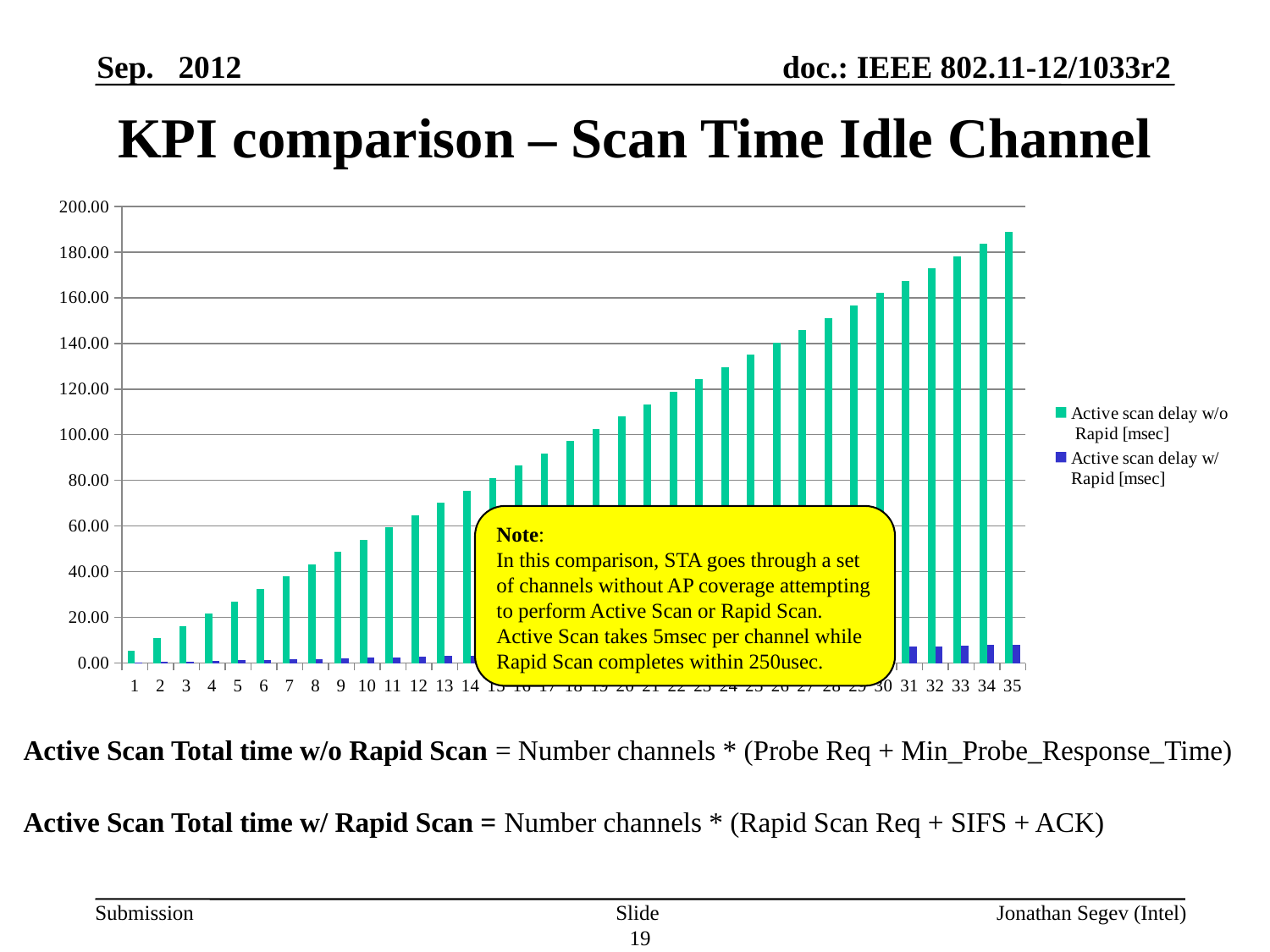
How many categories are shown along the x axis? 35 Is the value for 'Active scan delay w/o Rapid [msec]' at category 35 greater or less than 180? greater Is the value for 'Active scan delay w/o Rapid [msec]' at category 20 greater or less than 100? greater Which category has the highest value for the 'Active scan delay w/o Rapid [msec]' series? 35 What is the title of the slide containing the chart? KPI comparison – Scan Time Idle Channel Is the value for 'Active scan delay w/ Rapid [msec]' at category 35 greater or less than 20? less Which category has the lowest value for the 'Active scan delay w/o Rapid [msec]' series? 1 At category 35, which series has the larger value: 'Active scan delay w/o Rapid [msec]' or 'Active scan delay w/ Rapid [msec]'? Active scan delay w/o Rapid [msec] Do the values for 'Active scan delay w/o Rapid [msec]' rise or fall as the category number increases along the x axis? rise How many series does the legend list? 2 What kind of chart is shown on the slide? bar chart